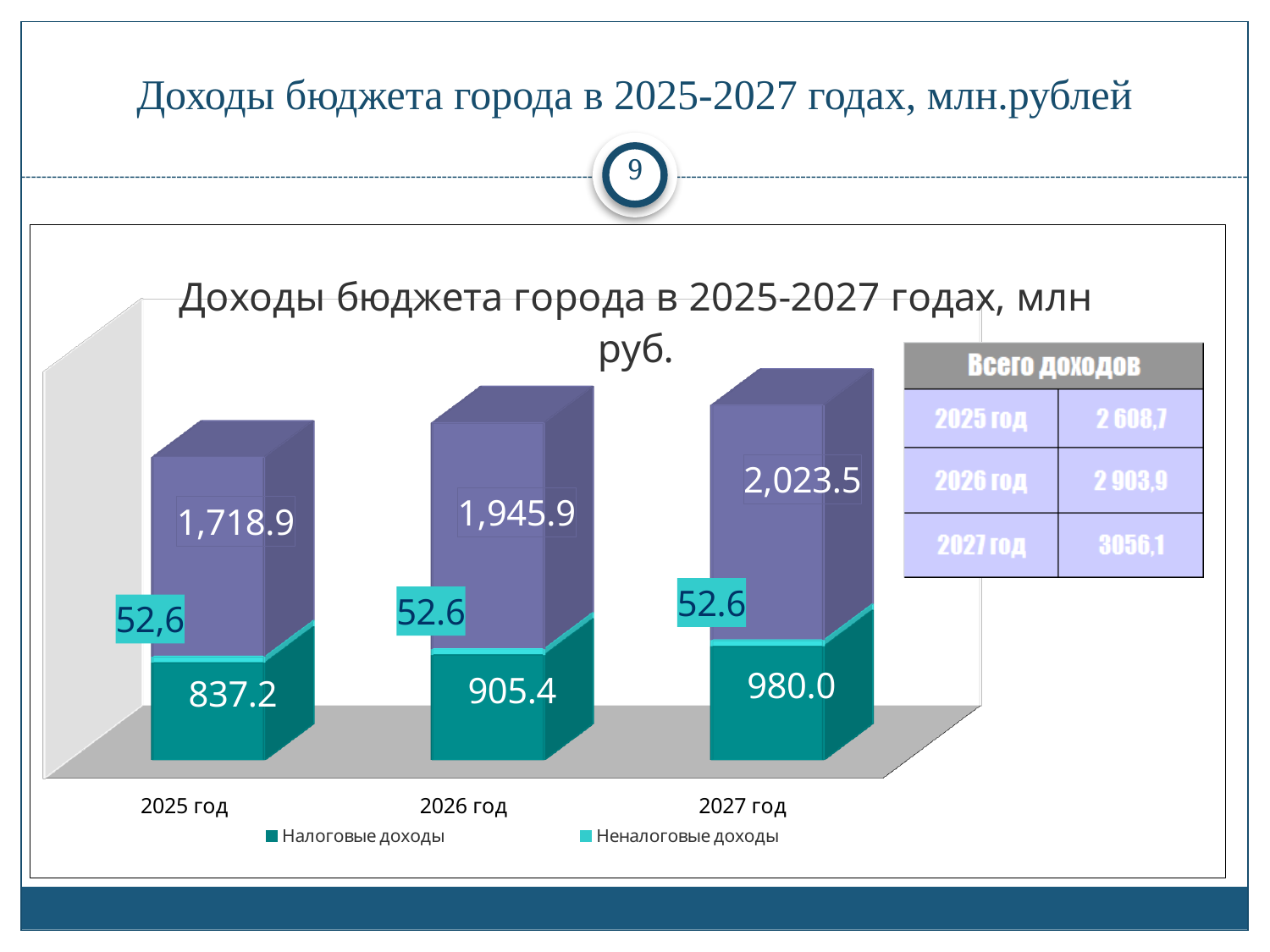
Do the values for Налоговые доходы rise or fall from 2025 год to 2027 год? Rise What is the value of Налоговые доходы for 2027 год? 980.0 What is the value of Неналоговые доходы for 2026 год? 52.6 What kind of chart is shown? Stacked bar chart Which year has the highest value for Налоговые доходы? 2027 год Which is larger: Налоговые доходы in 2026 год or in 2025 год? 2026 год Which year has the lowest value printed on the top purple segment? 2025 год What is the value of Налоговые доходы for 2025 год? 837.2 What is the difference between Налоговые доходы in 2027 год and 2025 год? 142.8 How many series does the legend list? 2 How many years (categories) are shown on the x axis? 3 What value is printed on the top purple segment of the bar for 2026 год? 1,945.9